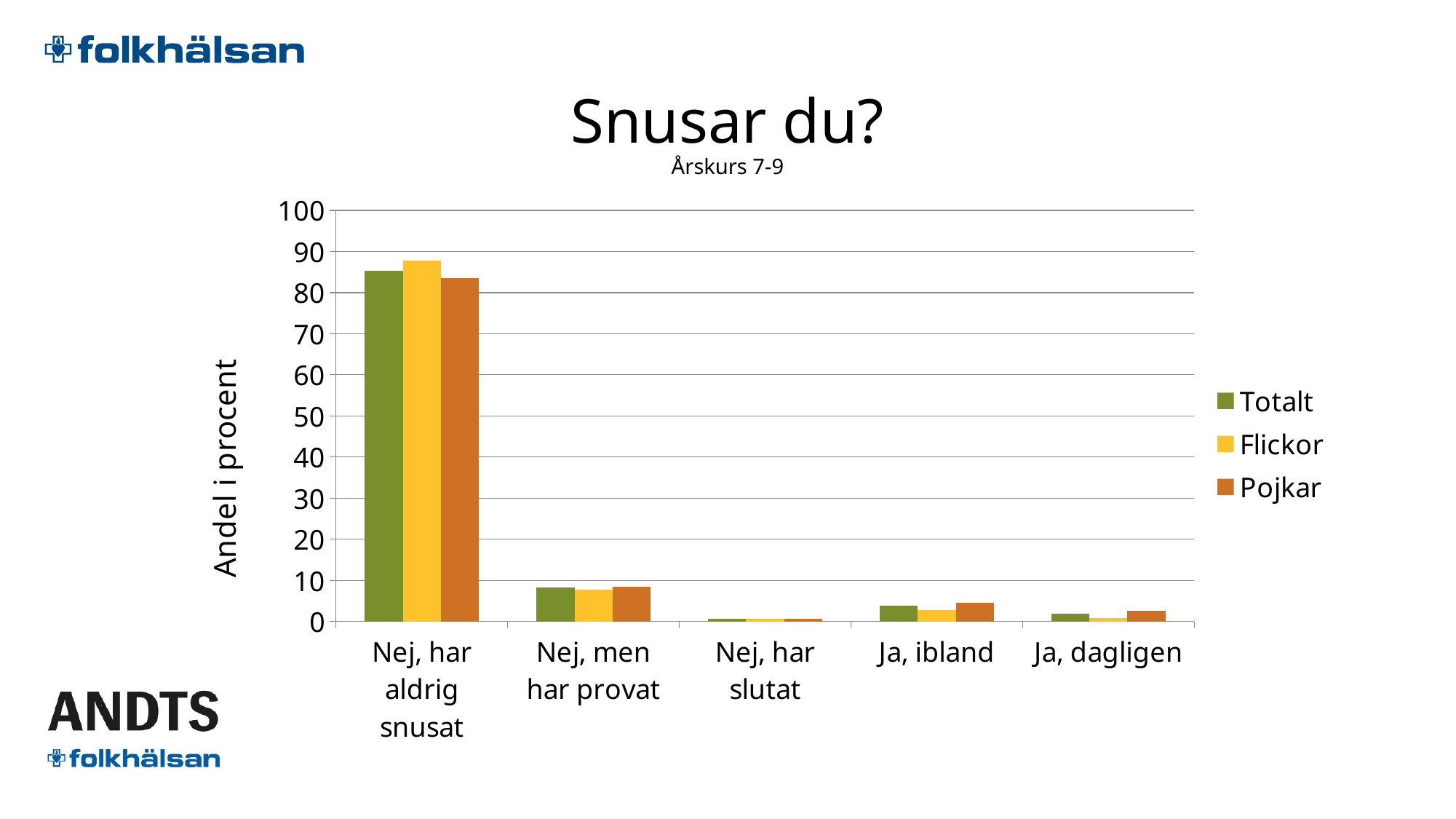
In the category Nej, har aldrig snusat, which is larger: Flickor or Pojkar? Flickor In the category Ja, ibland, which is larger: Flickor or Pojkar? Pojkar What is the label of the y axis? Andel i procent What kind of chart is shown on the slide? bar chart Is the value for Totalt in the category Nej, har aldrig snusat greater or less than 90? less Is the value for Flickor in the category Nej, har aldrig snusat greater or less than 80? greater Which category has the lowest value for Totalt? Nej, har slutat What is the title of the chart? Snusar du? Is the value for Pojkar in the category Nej, men har provat greater or less than 10? less How many series does the legend list? 3 How many categories are shown on the x axis of the chart? 5 Which category has the highest value for Totalt? Nej, har aldrig snusat